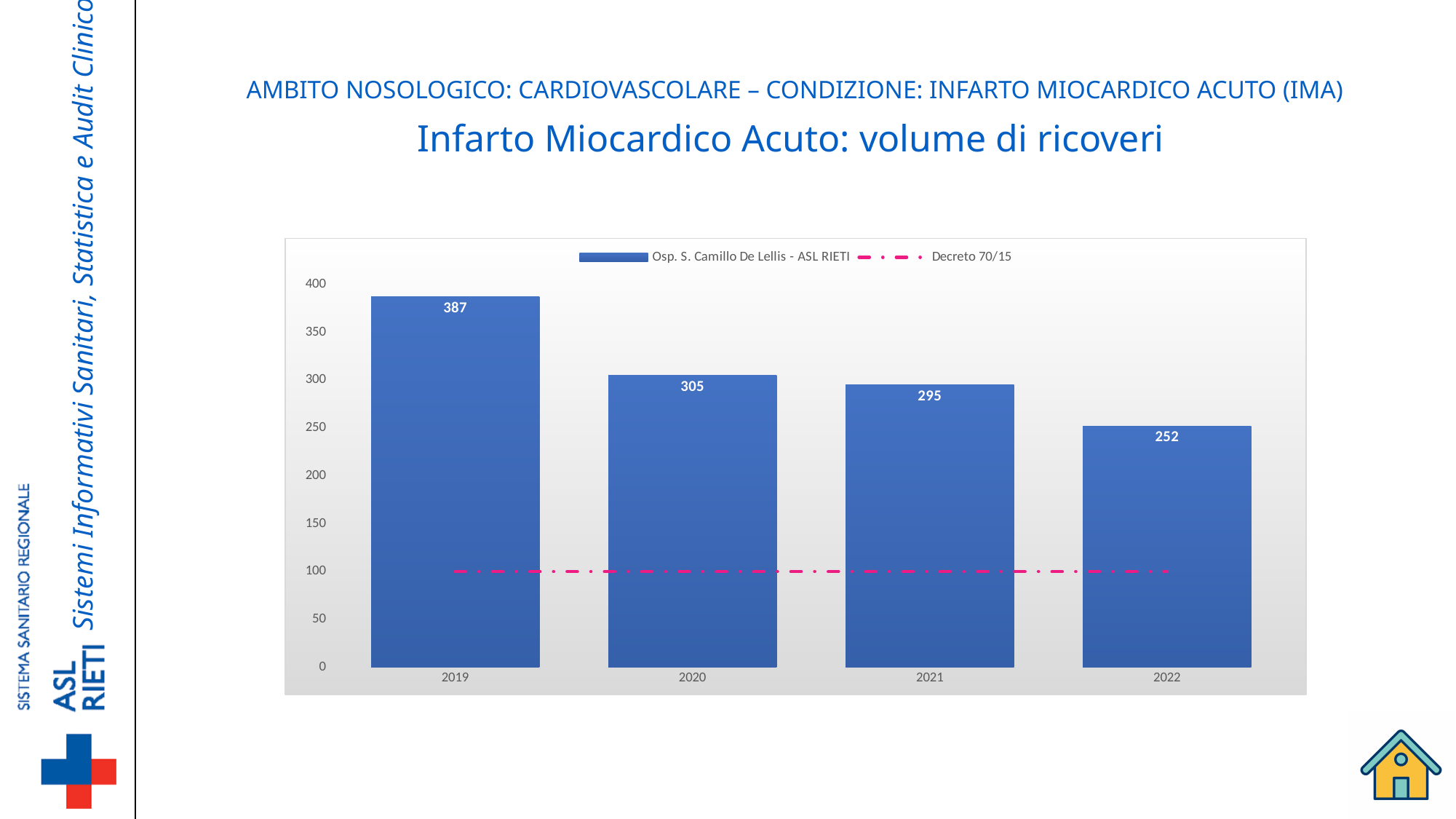
What is the difference between the 2019 and 2022 values? 135 What is the difference between the 2020 and 2021 values? 10 Which year has the lowest number of ricoveri? 2022 What is the value for 2022 for Osp. S. Camillo De Lellis - ASL RIETI? 252 How many years are shown on the x axis? 4 What is the value for 2020 for Osp. S. Camillo De Lellis - ASL RIETI? 305 Which year has the highest number of ricoveri? 2019 Is the Decreto 70/15 line greater or less than 150? less What kind of chart is shown on the slide? combination bar and line chart How many series does the legend list? 2 What is the value for 2019 for Osp. S. Camillo De Lellis - ASL RIETI? 387 Which is larger, the value for 2020 or the value for 2021? 2020